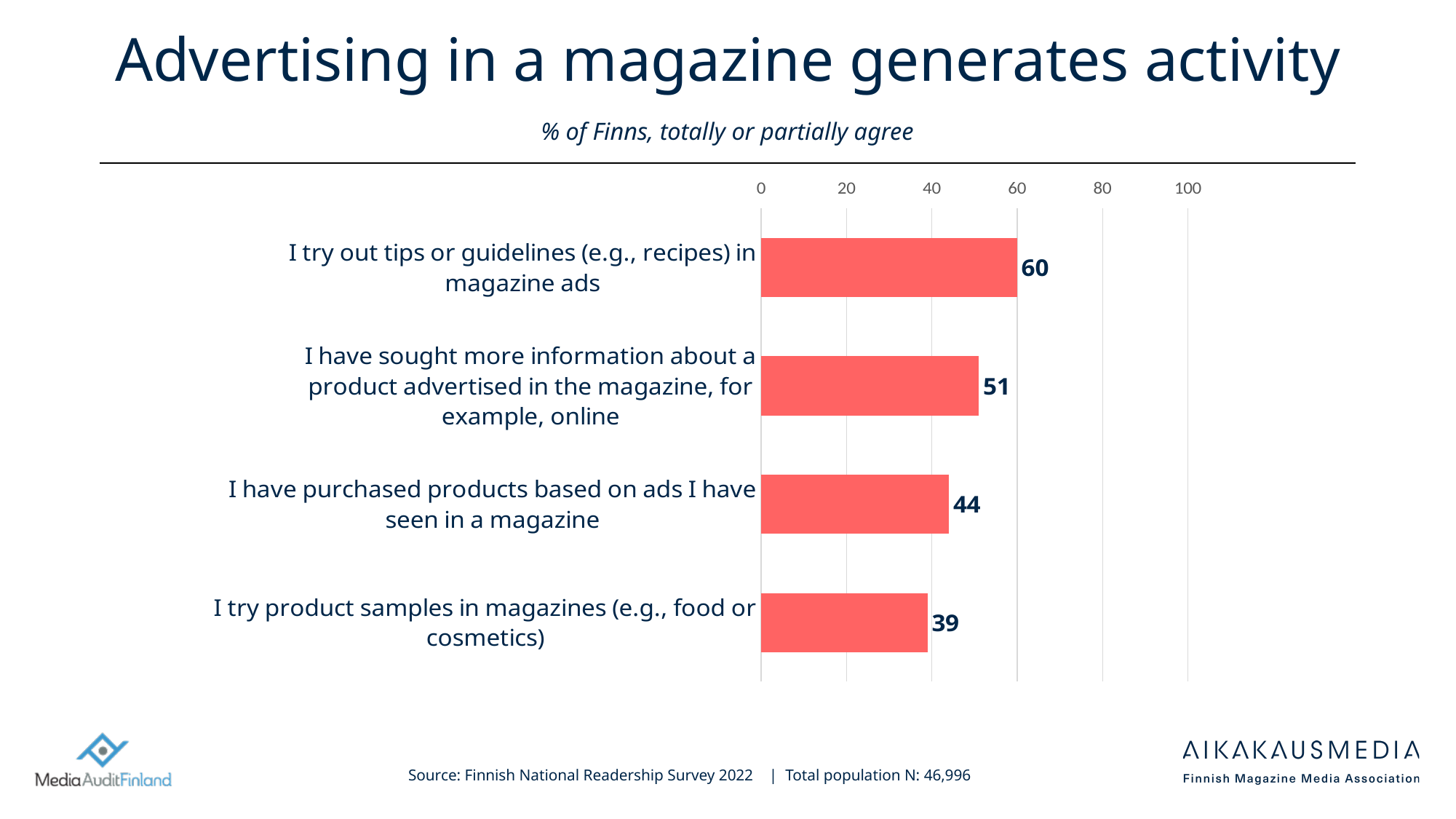
What is the difference between the values for seeking more information about an advertised product and purchasing products based on magazine ads? 7 What is the difference between the values for trying out tips or guidelines in magazine ads and trying product samples in magazines? 21 What value is shown for "I have purchased products based on ads I have seen in a magazine"? 44 What kind of chart is shown on the slide? Bar chart What is the subtitle shown above the chart? % of Finns, totally or partially agree How many statements (categories) are shown in the chart? 4 Which statement has the highest percentage of agreement? I try out tips or guidelines (e.g., recipes) in magazine ads Which is larger: the value for purchasing products based on magazine ads or the value for trying product samples in magazines? I have purchased products based on ads I have seen in a magazine Which statement has the lowest percentage of agreement? I try product samples in magazines (e.g., food or cosmetics) What value is shown for "I try product samples in magazines (e.g., food or cosmetics)"? 39 What percentage of Finns agree with "I try out tips or guidelines (e.g., recipes) in magazine ads"? 60 What value is shown for "I have sought more information about a product advertised in the magazine, for example, online"? 51